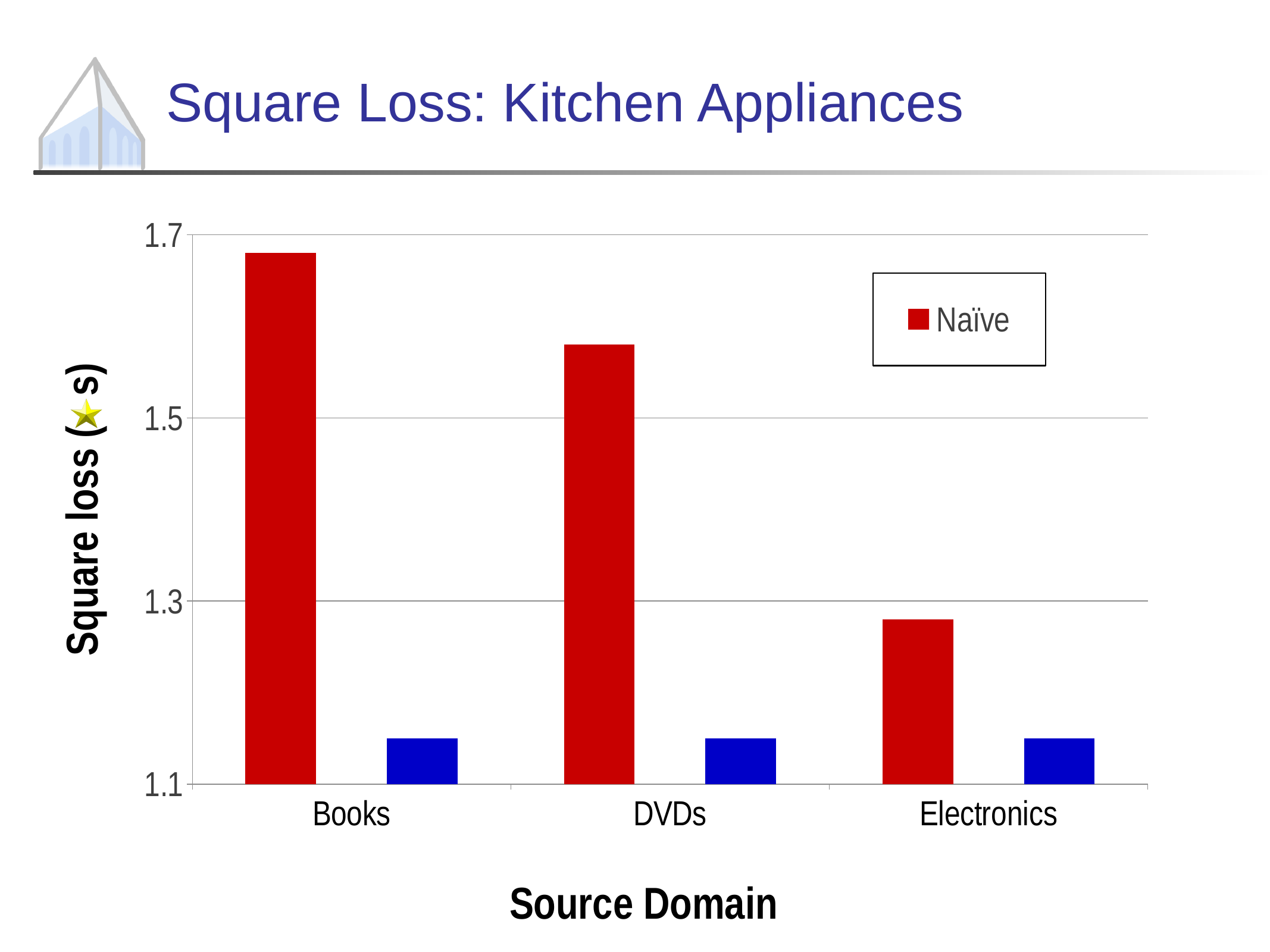
Do the Naïve values rise or fall from Books to Electronics along the x axis? fall Which source domain has the lowest Naïve square loss? Electronics Is the Naïve value for Books greater or less than 1.5? greater Is the blue bar for Books greater or less than 1.3? less Which source domain has the highest Naïve square loss? Books Is the Naïve value for Electronics greater or less than 1.3? less How many series does the legend list? 1 What is the title of the x axis? Source Domain How many source domain categories are shown on the x axis? 3 Which has the larger Naïve square loss, Books or DVDs? Books What kind of chart is shown on the slide? bar chart